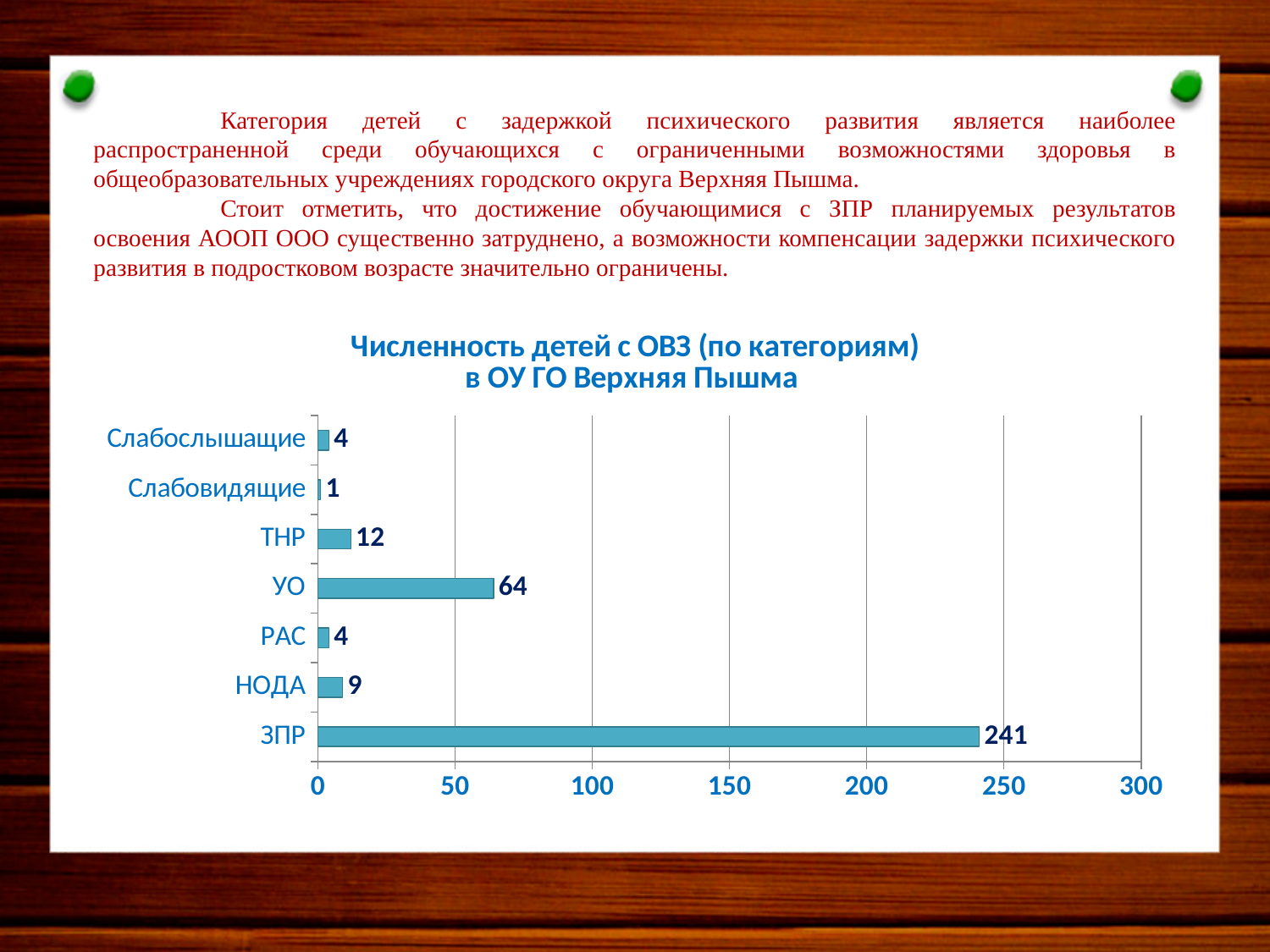
What is the value for НОДА? 9 Is the value for ЗПР greater or less than 200? greater What kind of chart is shown on the slide? bar chart What is the value for ТНР? 12 Which is larger, the value for ТНР or the value for НОДА? ТНР How many categories are shown in the chart? 7 Which category has the lowest value? Слабовидящие Which category has the highest value? ЗПР What is the value for ЗПР? 241 What is the title of the chart? Численность детей с ОВЗ (по категориям) в ОУ ГО Верхняя Пышма What is the value for УО? 64 What is the difference between the values for ЗПР and УО? 177